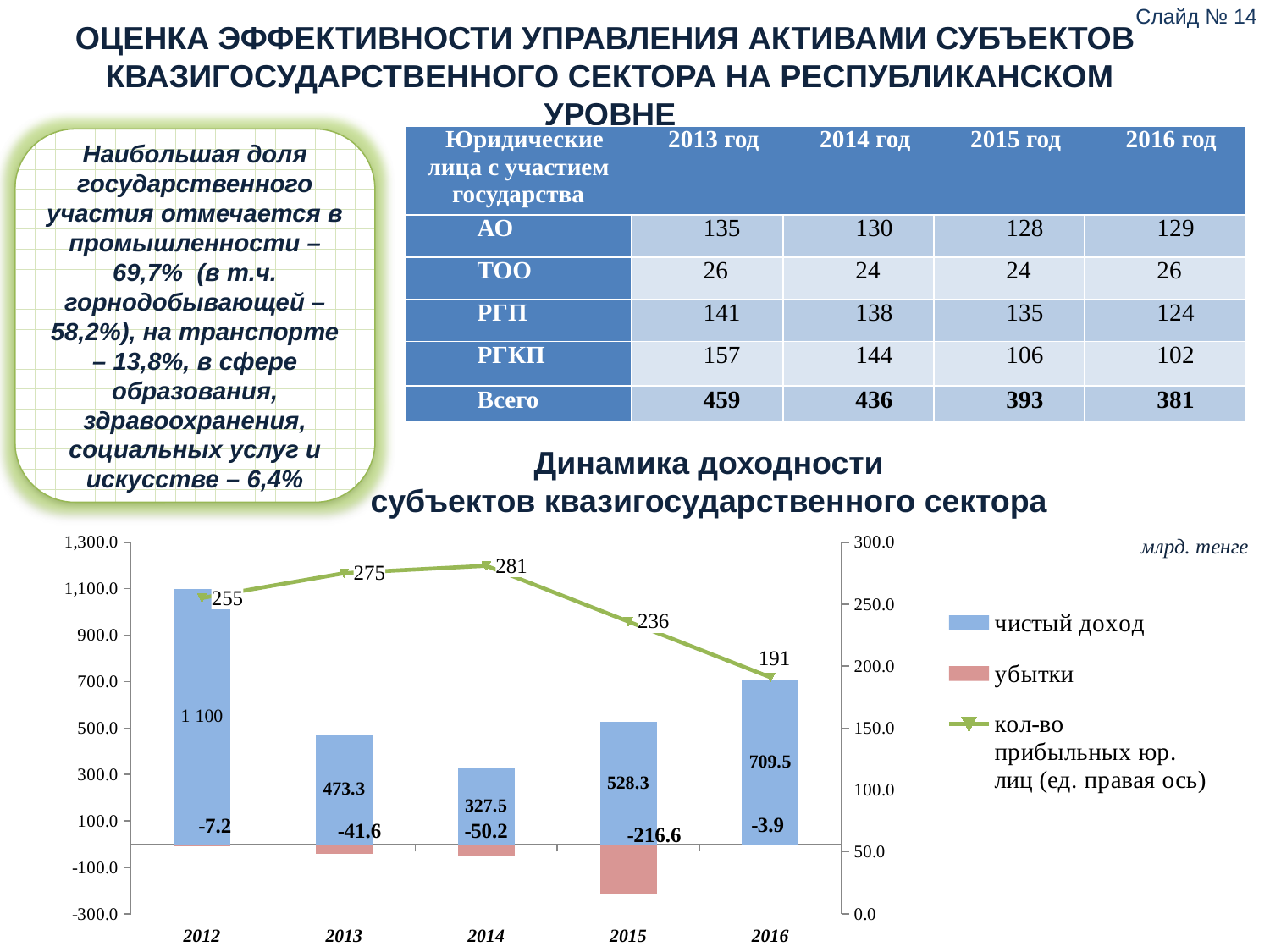
Does кол-во прибыльных юр. лиц rise or fall from 2014 to 2016? fall How many series does the chart legend list? 3 Which year has the lowest value of кол-во прибыльных юр. лиц? 2016 What is the value of кол-во прибыльных юр. лиц for 2013? 275 Which year has the highest чистый доход? 2012 Which is larger, чистый доход in 2013 or in 2015? 2015 What is the value of убытки for 2015? -216.6 What unit is indicated in the top right corner of the chart? млрд. тенге What kind of chart is used for чистый доход and убытки? bar chart What is the value of чистый доход for 2014? 327.5 How many years are shown on the x axis of the chart? 5 What is the difference between чистый доход in 2016 and in 2015? 181.2